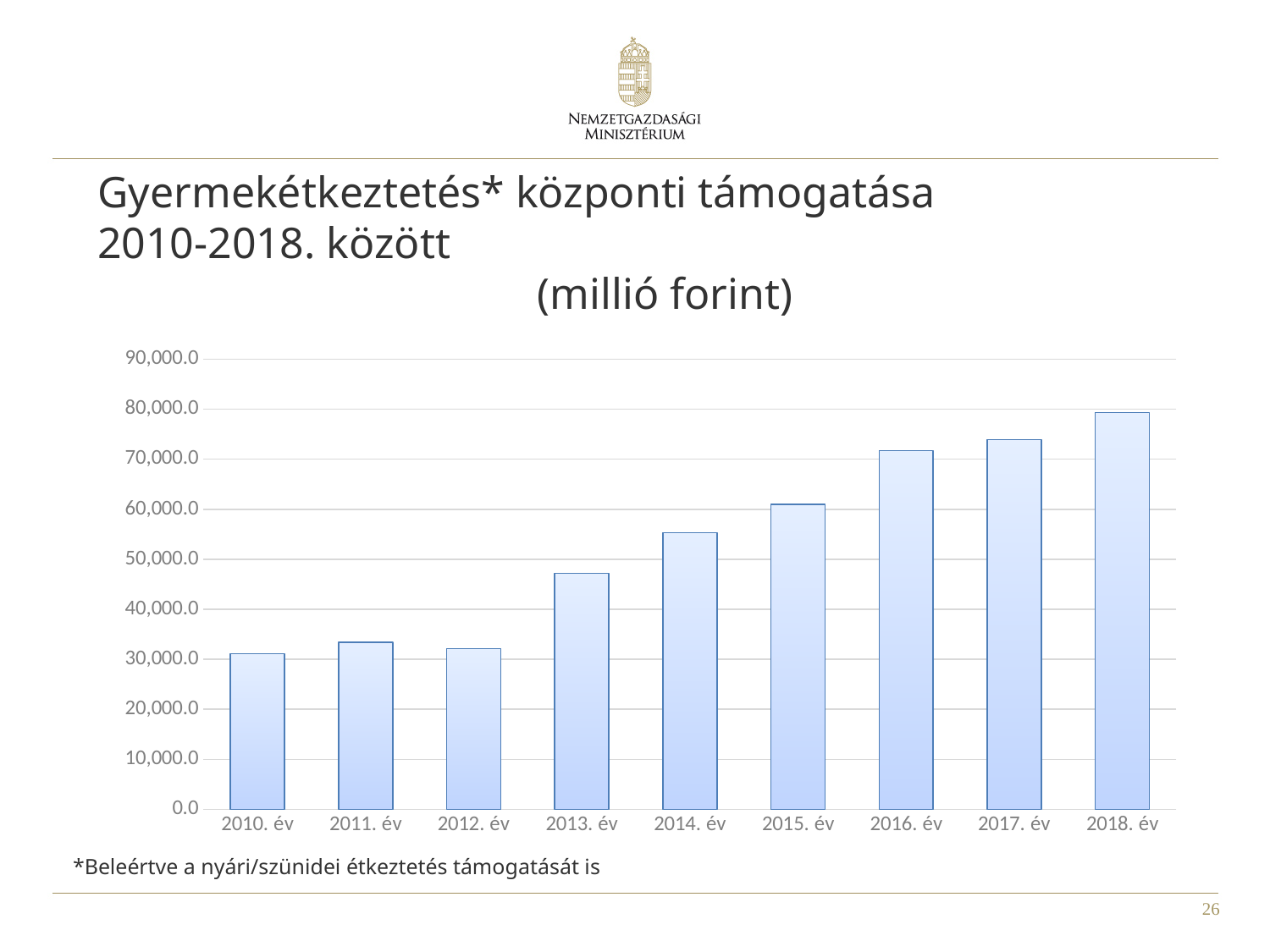
In what unit are the values on the chart expressed, according to the title? millió forint Do the values generally rise or fall from 2010. év to 2018. év? rise Is the value for 2011. év greater or less than 40,000.0? less Is the value for 2013. év greater or less than 40,000.0? greater Is the value for 2014. év greater or less than 50,000.0? greater What kind of chart is shown on the slide? bar chart Which year has the highest value? 2018. év How many years are plotted on the x axis? 9 Which is larger, the value for 2016. év or the value for 2013. év? 2016. év Which is larger, the value for 2010. év or the value for 2018. év? 2018. év